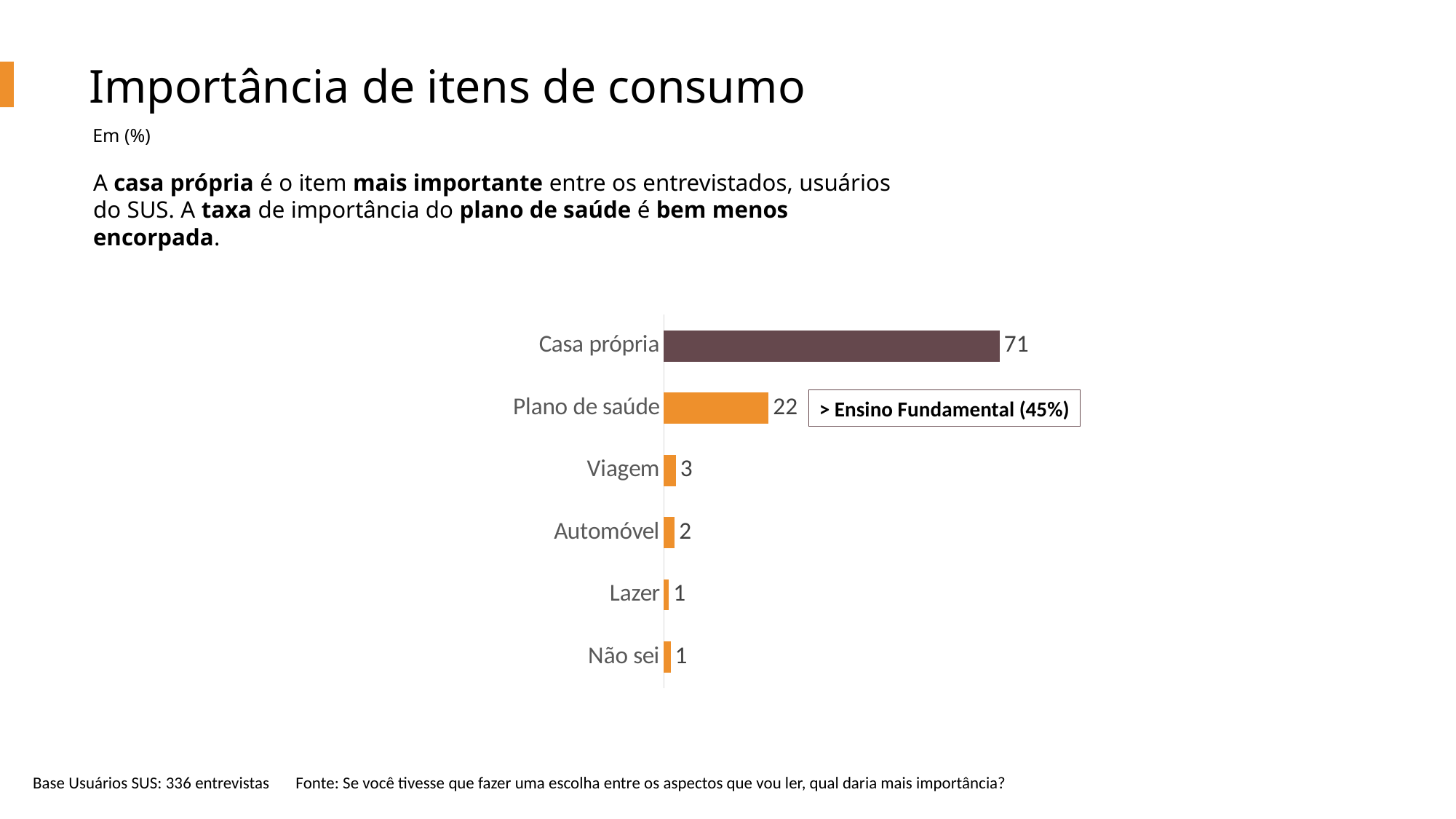
What is the difference between the values for Casa própria and Plano de saúde? 49 What is the value for Plano de saúde? 22 What is the value for Automóvel? 2 Which is larger, the value for Viagem or the value for Automóvel? Viagem What is the difference between the values for Plano de saúde and Viagem? 19 How many categories are shown in the chart? 6 What is the value for Casa própria? 71 Which category's bar is coloured differently (dark brown) from the others? Casa própria What kind of chart is shown on the slide? Bar chart What is the title of the slide containing the chart? Importância de itens de consumo Which category has the highest value? Casa própria What is the value for Viagem? 3